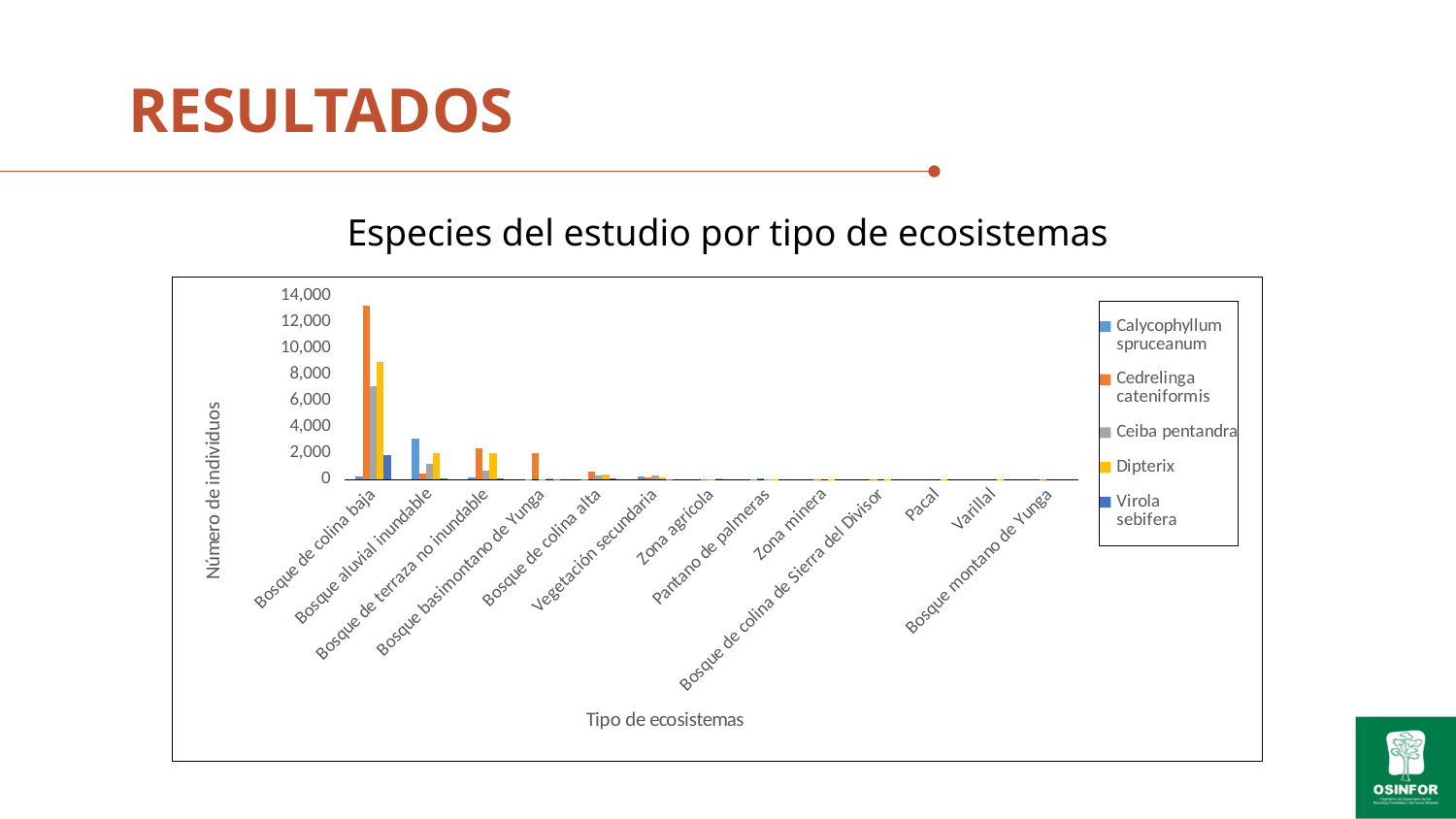
Is the value for Calycophyllum spruceanum in Bosque aluvial inundable greater or less than 2,000? greater What is the label of the vertical axis? Número de individuos In Bosque de colina baja, which is larger: the value for Cedrelinga cateniformis or the value for Dipterix? Cedrelinga cateniformis Is the value for Cedrelinga cateniformis in Bosque de colina baja greater or less than 12,000? greater Is the value for Ceiba pentandra in Bosque de colina baja greater or less than 6,000? greater How many ecosystem types (categories) are shown on the x axis? 13 Which species has the highest value in Bosque de colina baja? Cedrelinga cateniformis What kind of chart is shown on the slide? bar chart What is the title of the chart? Especies del estudio por tipo de ecosistemas Which ecosystem type has the tallest bar in the chart? Bosque de colina baja How many series does the legend list? 5